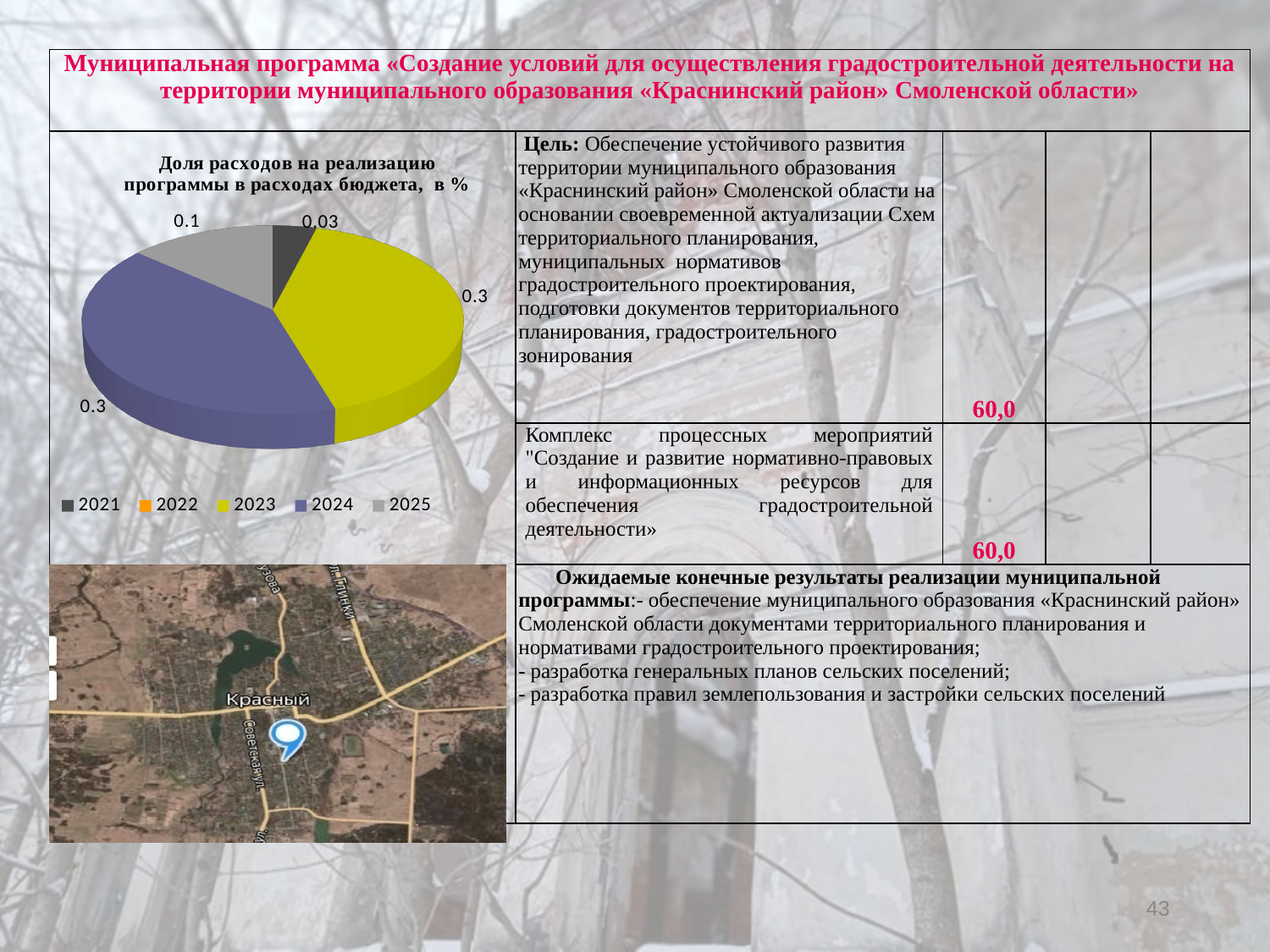
What is the title of the pie chart on the slide? Доля расходов на реализацию программы в расходах бюджета, в % In the pie chart, what is the difference between the values for 2023 and 2025? 0.2 What type of chart is shown on the left of the slide? pie chart In the pie chart, which is larger, the value for 2024 or the value for 2025? 2024 In the pie chart, what is the value for 2025? 0.1 In the pie chart, which is larger, the value for 2021 or the value for 2025? 2025 In the pie chart, which colour represents 2023 in the legend? yellow In the pie chart, what is the value for 2023? 0.3 In the pie chart, what is the difference between the values for 2024 and 2021? 0.27 In the pie chart, what is the value for 2024? 0.3 In the pie chart, what is the value for 2021? 0.03 How many entries does the legend of the pie chart list? 5